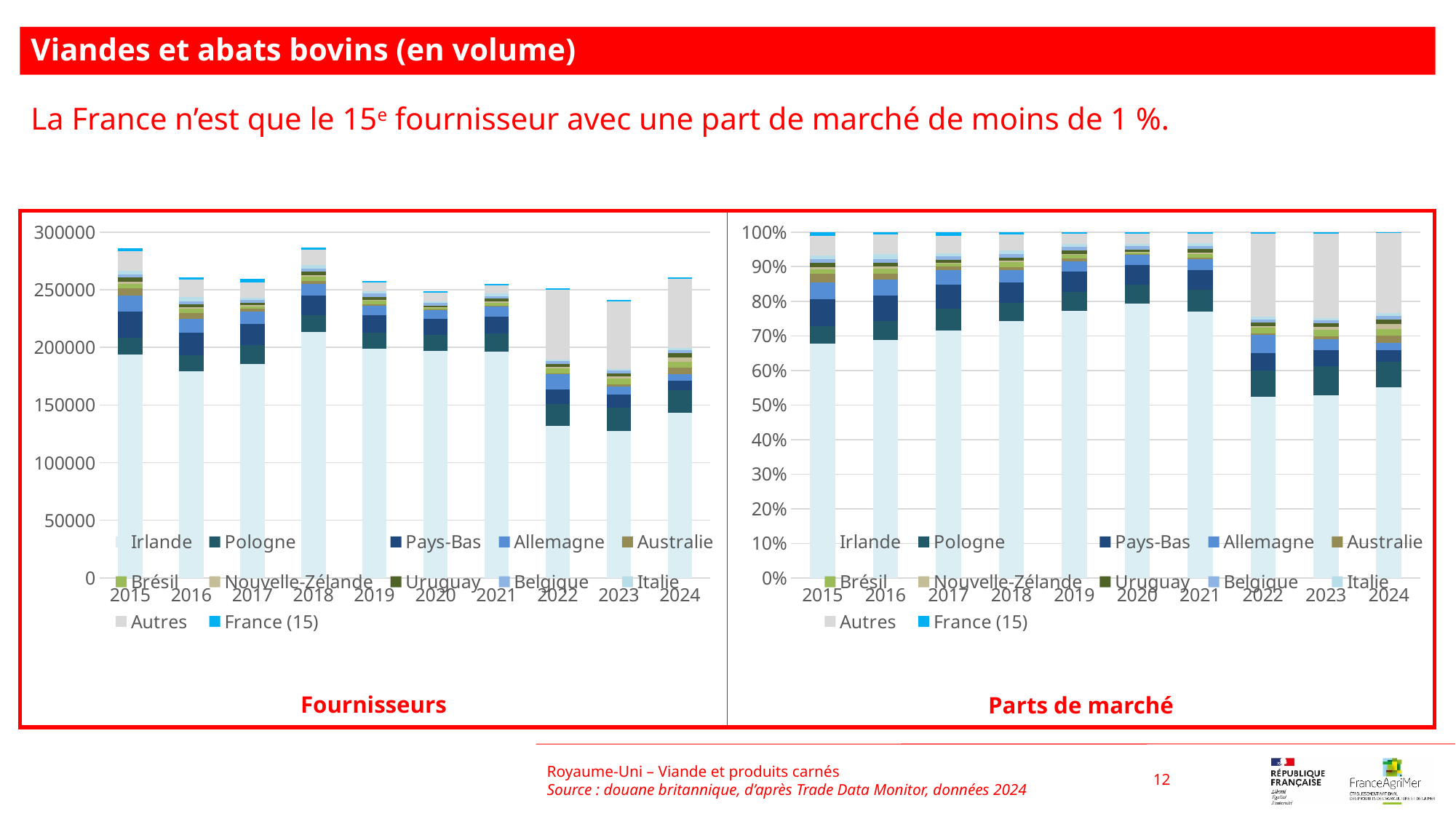
How many series does the legend of the 'Fournisseurs' chart list? 12 What is the title shown under the right-hand chart? Parts de marché In the 'Fournisseurs' chart, is the total height of the 2018 bar greater or less than 250000? greater In the 'Fournisseurs' chart, is the Irlande value for 2023 greater or less than 150000? less How many years are shown on the x axis of the 'Parts de marché' chart? 10 What kind of chart is the 'Fournisseurs' chart on the left? Stacked bar chart In the 'Parts de marché' chart, is the Irlande share in 2020 greater or less than 70%? greater In the 'Parts de marché' chart, does the Irlande share rise or fall from 2021 to 2022? fall In the 'Parts de marché' chart, which year has the larger Irlande share, 2020 or 2023? 2020